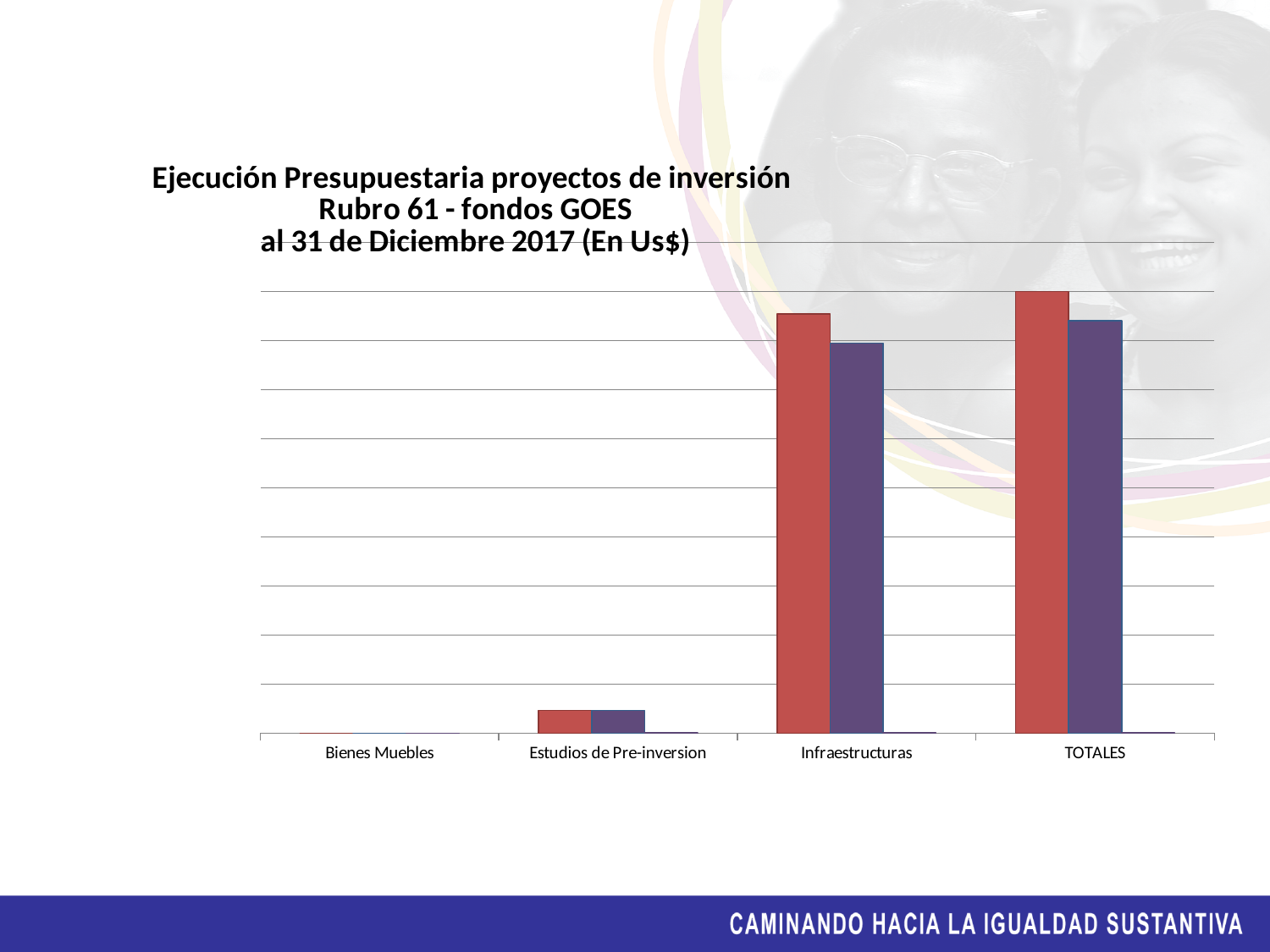
Which category has the tallest bars in the chart? TOTALES For TOTALES, which bar is taller, the red one or the purple one? the red one What kind of chart is shown on the slide? bar chart Which category has the smallest bars in the chart? Bienes Muebles What is the first line of the chart's title? Ejecución Presupuestaria proyectos de inversión Which category has larger bars, Estudios de Pre-inversion or Bienes Muebles? Estudios de Pre-inversion Do the bar heights generally rise or fall moving from left to right across the categories? rise Which category has larger bars, Infraestructuras or Estudios de Pre-inversion? Infraestructuras How many categories are shown on the x axis of the chart? 4 According to the chart title, as of what date is the budget execution reported? al 31 de Diciembre 2017